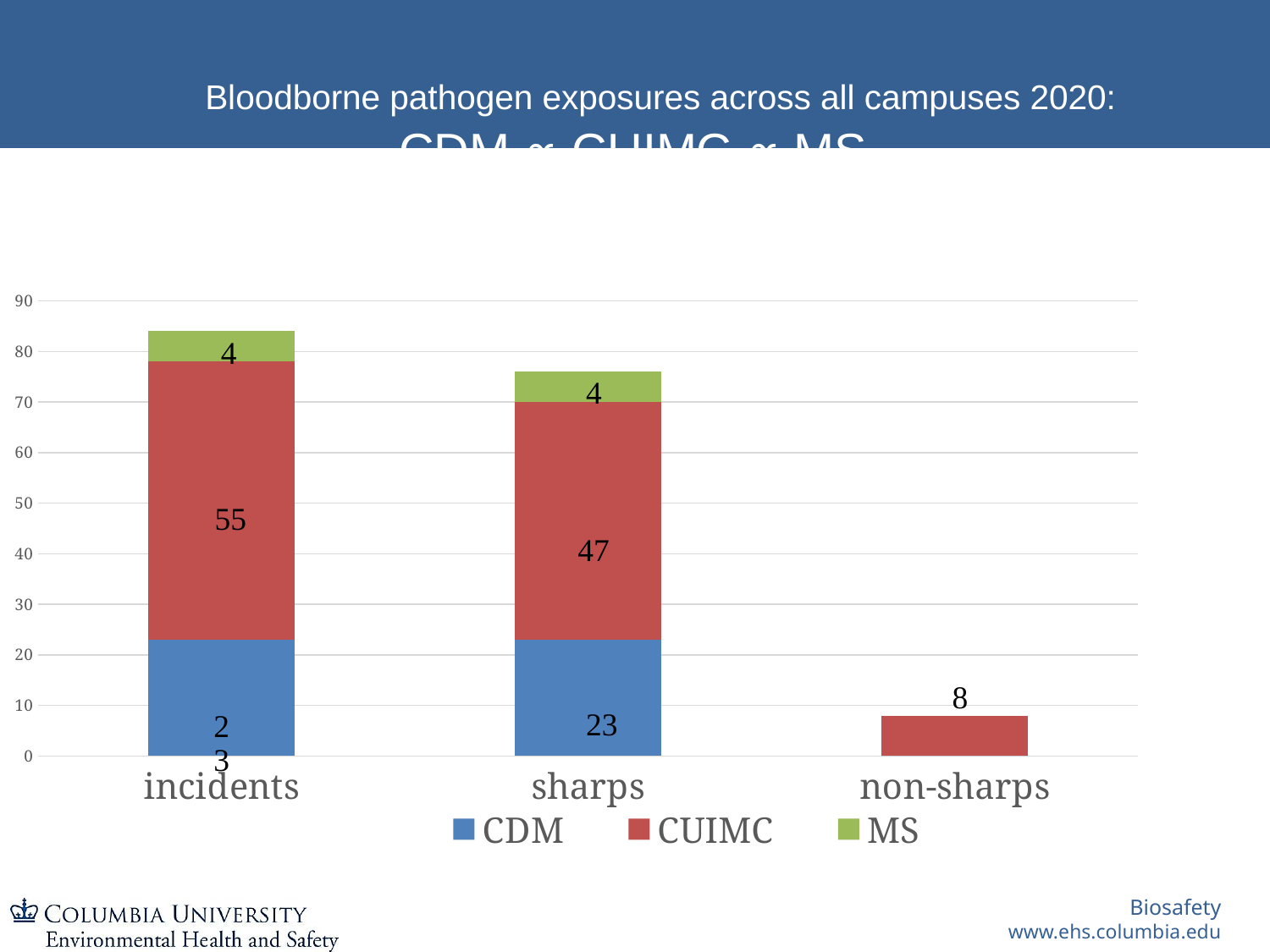
Which category has the tallest stacked bar? incidents What is the MS value for the sharps category? 4 What is the difference between the CUIMC value for incidents and the CUIMC value for sharps? 8 How many series does the legend list? 3 What is the CUIMC value for the incidents category? 55 What is the CDM value for the sharps category? 23 What is the CUIMC value for the non-sharps category? 8 What kind of chart is shown on the slide? stacked bar chart Which is larger, the CUIMC value for incidents or the CUIMC value for sharps? incidents How many categories are shown on the x axis? 3 What is the CUIMC value for the sharps category? 47 Which category has the shortest stacked bar? non-sharps